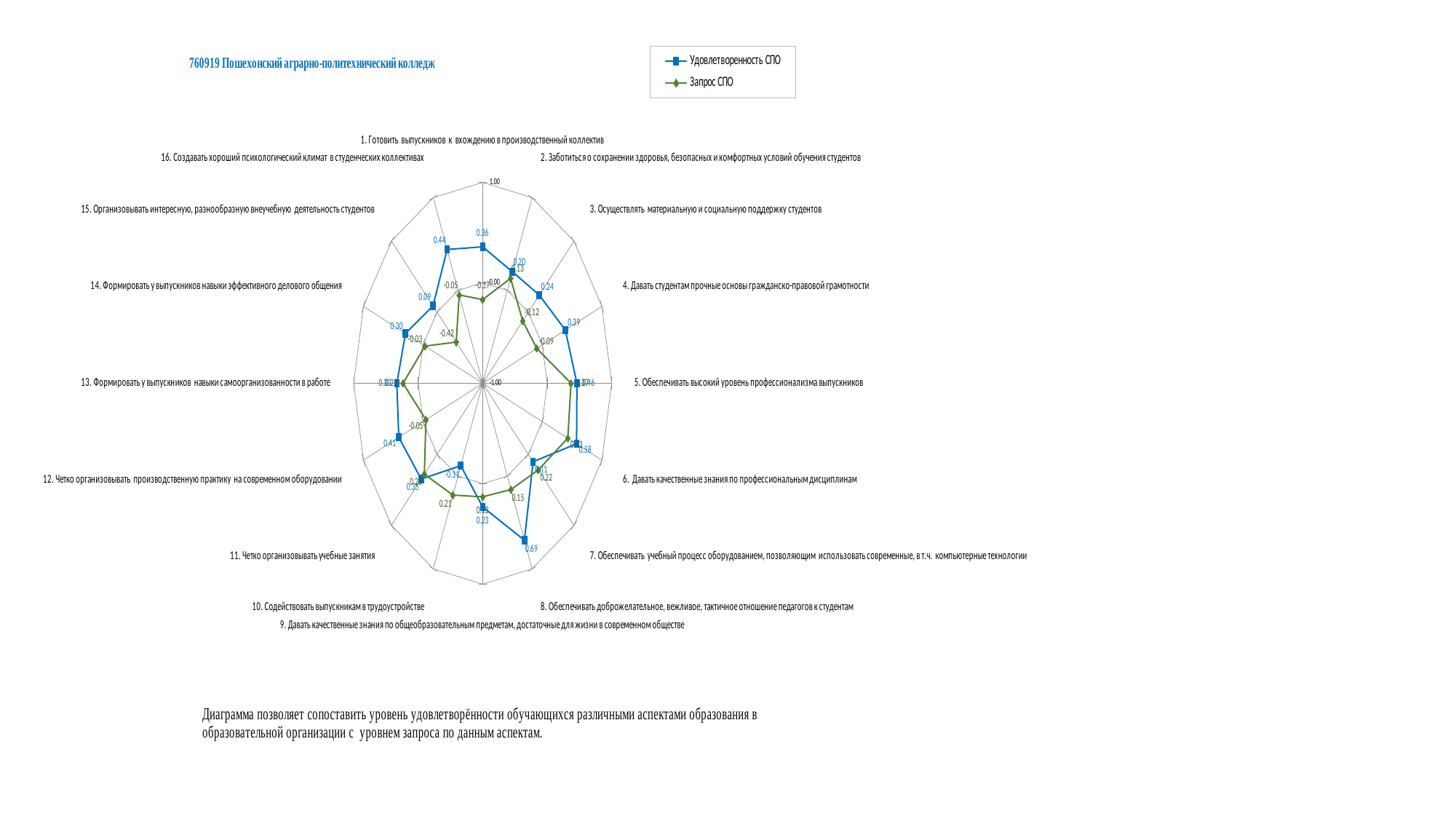
What is the difference between the "Удовлетворенность СПО" values for category 16 and category 1? 0.08 For which category is the "Запрос СПО" value the highest? 6. Давать качественные знания по профессиональным дисциплинам What is the value of "Удовлетворенность СПО" for category 4 "Давать студентам прочные основы гражданско-правовой грамотности"? 0.39 What kind of chart is shown on the slide? Radar chart What is the value of "Запрос СПО" for category 15 "Организовывать интересную, разнообразную внеучебную деятельность студентов"? -0.42 For category 12 "Четко организовывать производственную практику на современном оборудовании", which series has the larger value: "Удовлетворенность СПО" or "Запрос СПО"? Удовлетворенность СПО What is the value of "Удовлетворенность СПО" for category 16 "Создавать хороший психологический климат в студенческих коллективах"? 0.44 What is the value of "Удовлетворенность СПО" for category 1 "Готовить выпускников к вхождению в производственный коллектив"? 0.36 For which category is the "Удовлетворенность СПО" value the lowest? 10. Содействовать выпускникам в трудоустройстве How many categories (axes) does the radar chart have? 16 How many series does the legend list? 2 What is the value of "Удовлетворенность СПО" for category 8 "Обеспечивать доброжелательное, вежливое, тактичное отношение педагогов к студентам"? 0.69